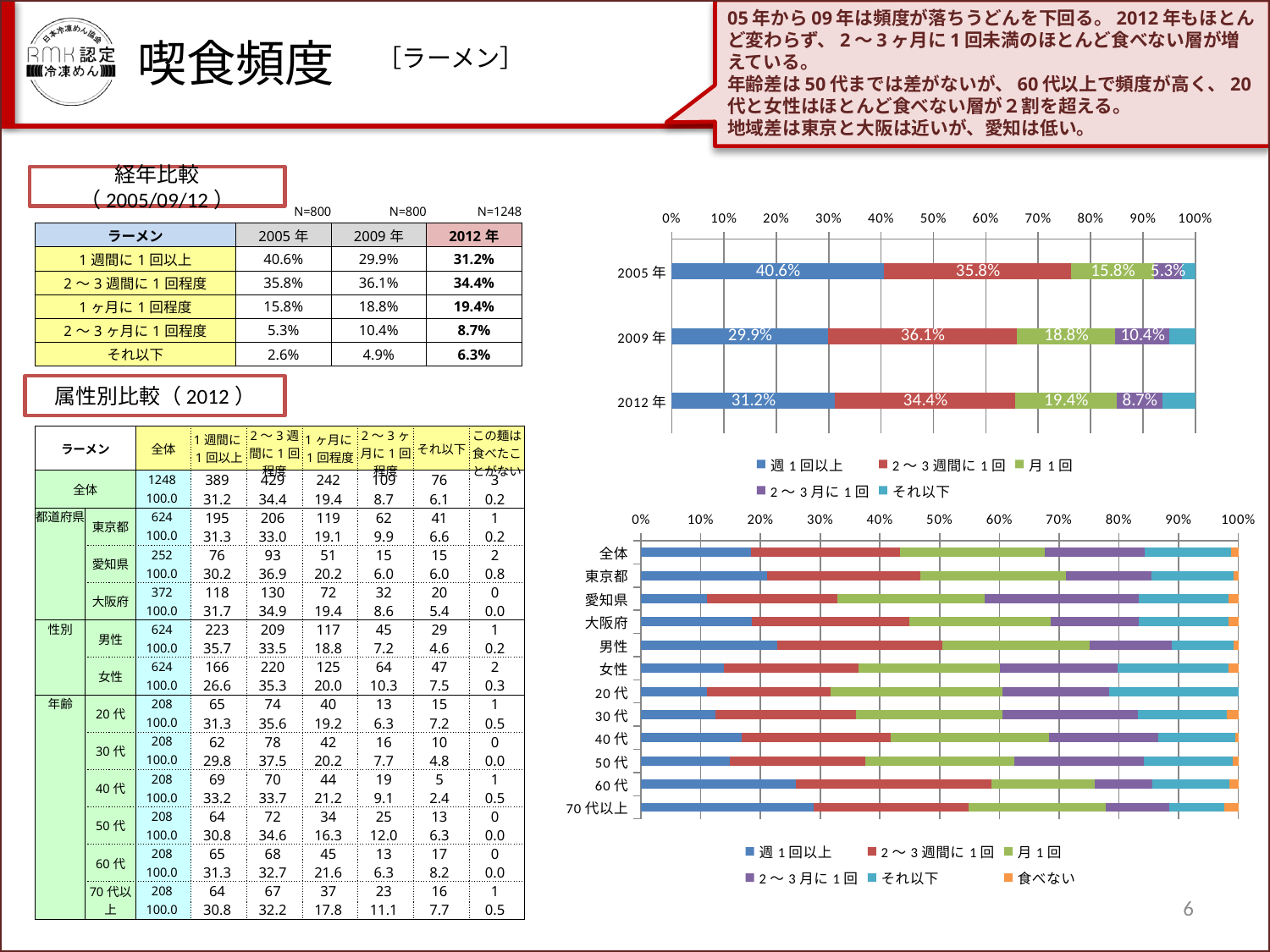
In the top-right chart, which year has the highest value for 週1回以上? 2005年 In the top-right chart, what is the value of 週1回以上 for 2005年? 40.6% In the top-right chart, what is the value of 2～3週間に1回 for 2009年? 36.1% In the bottom-right chart, which has the larger 週1回以上 segment, 男性 or 女性? 男性 In the bottom-right chart, is the value of 週1回以上 for 愛知県 greater or less than 40%? less How many series does the legend of the bottom-right chart list? 6 What kind of chart is the top-right chart? stacked bar chart In the top-right chart, what is the value of 2～3月に1回 for 2012年? 8.7% In the top-right chart, does the value of 月1回 rise or fall from 2005年 to 2012年? rises How many series does the legend of the top-right chart list? 5 How many categories are shown on the vertical axis of the bottom-right chart? 12 In the top-right chart, what is the difference between the 週1回以上 values for 2005年 and 2012年? 9.4 percentage points